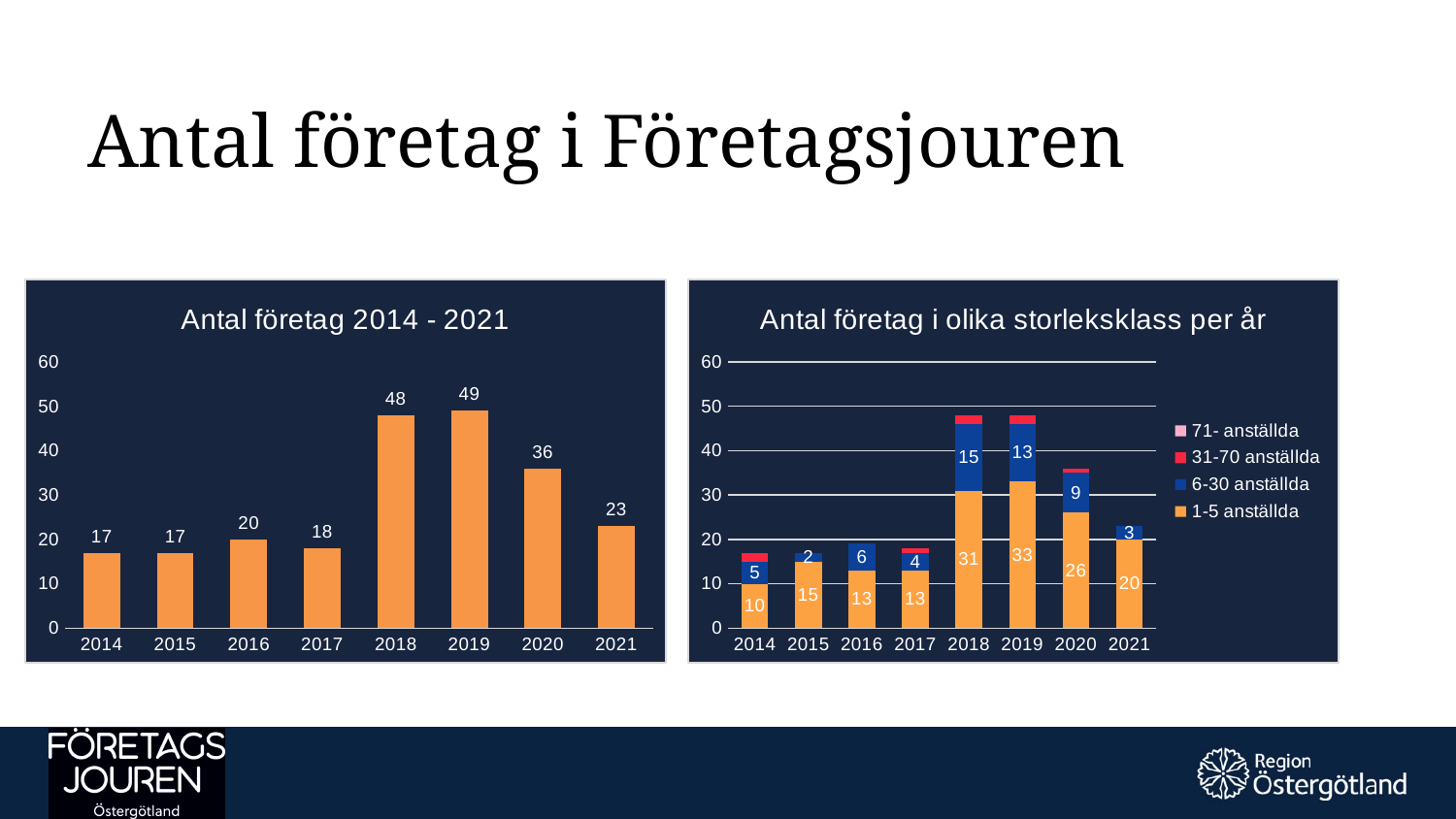
In the chart 'Antal företag i olika storleksklass per år', which is larger for 2020: '1-5 anställda' or '6-30 anställda'? 1-5 anställda In the chart 'Antal företag i olika storleksklass per år', how many series does the legend list? 4 In the chart 'Antal företag 2014 - 2021', what is the value for 2016? 20 In the chart 'Antal företag 2014 - 2021', what is the difference between the values for 2020 and 2021? 13 In the chart 'Antal företag i olika storleksklass per år', what is the difference between the '1-5 anställda' values for 2018 and 2021? 11 In the chart 'Antal företag 2014 - 2021', what is the value for 2019? 49 In the chart 'Antal företag 2014 - 2021', how many years are shown on the x axis? 8 What type of chart is 'Antal företag i olika storleksklass per år'? Stacked bar chart In the chart 'Antal företag i olika storleksklass per år', what is the value for '6-30 anställda' in 2018? 15 In the chart 'Antal företag i olika storleksklass per år', what is the value for '1-5 anställda' in 2019? 33 In the chart 'Antal företag 2014 - 2021', is the value for 2018 greater or less than 40? greater In the chart 'Antal företag 2014 - 2021', which year has the highest value? 2019